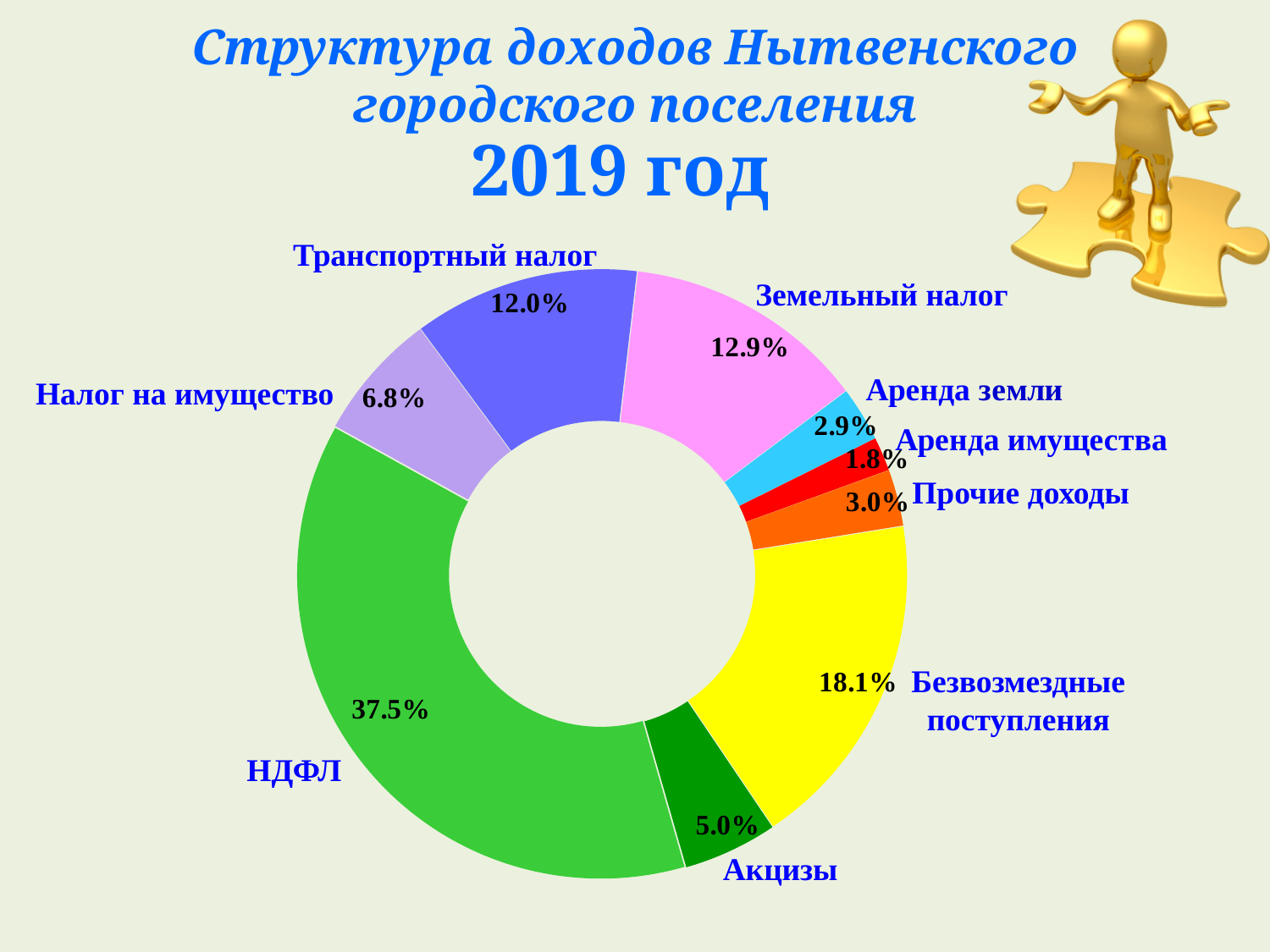
What is the value for Аренда имущества? 1.8% What kind of chart is shown on the slide? Doughnut (pie) chart What percentage is shown for Земельный налог? 12.9% How many categories are shown in the chart? 9 What is the difference between the shares of НДФЛ and Безвозмездные поступления? 19.4% Which category has the smallest share of revenue? Аренда имущества What is the value shown for Безвозмездные поступления? 18.1% What share of revenue does НДФЛ account for? 37.5% Which year does the chart title refer to? 2019 Which is larger, the share of Налог на имущество or the share of Акцизы? Налог на имущество Which category has the largest share of revenue? НДФЛ What is the difference between the shares of Земельный налог and Транспортный налог? 0.9%